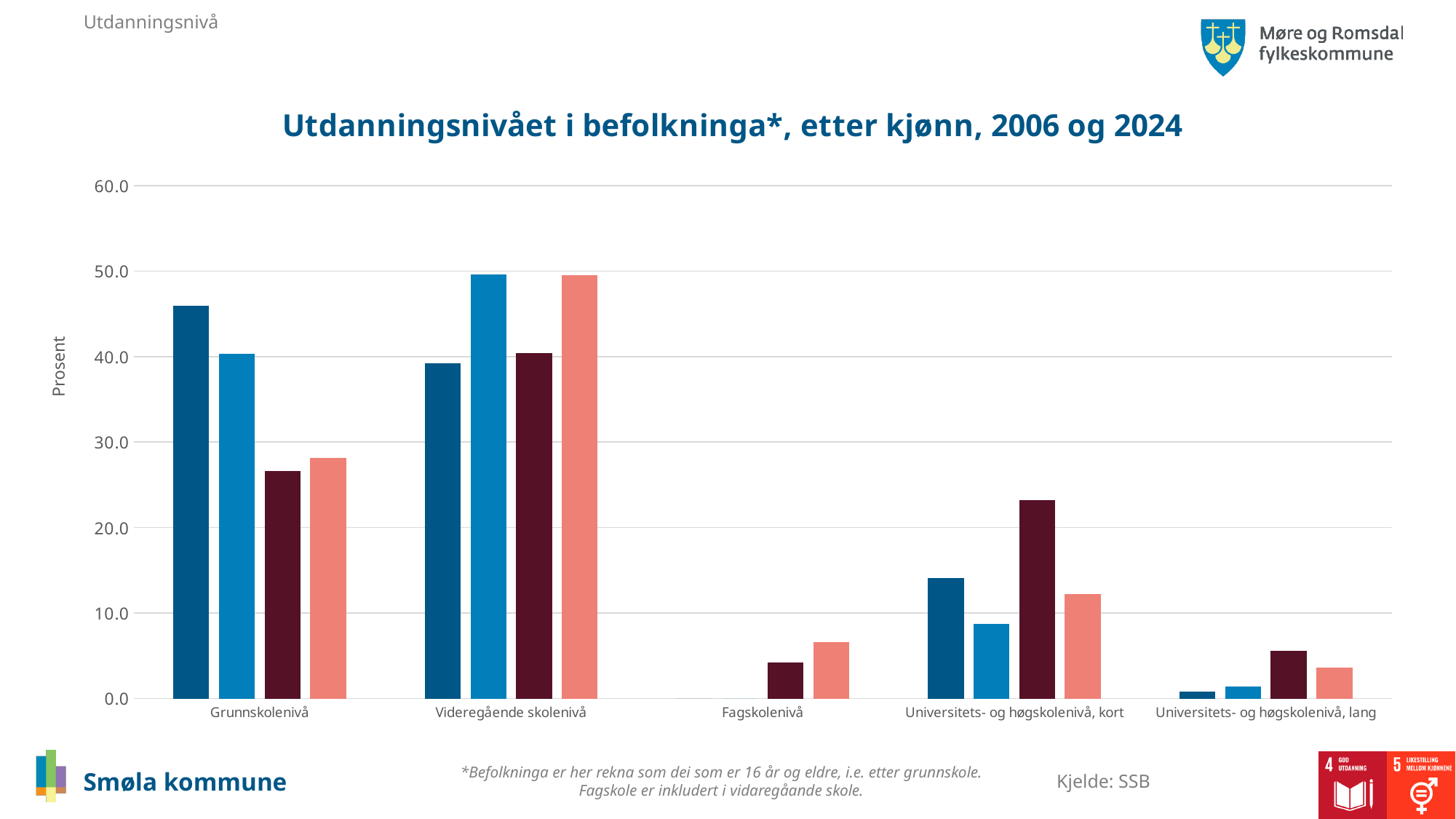
Is the value of the dark blue bar for Grunnskolenivå greater or less than 40? greater Is the value of the dark red bar for Grunnskolenivå greater or less than 30? less What is the label on the vertical axis? Prosent What is the title of the chart? Utdanningsnivået i befolkninga*, etter kjønn, 2006 og 2024 Is the value of the dark blue bar for Universitets- og høgskolenivå, lang greater or less than 10? less How many education-level categories are shown on the x axis? 5 How many bars are plotted for the Grunnskolenivå category? 4 What kind of chart is shown on the slide? bar chart Among the dark blue bars, which category has the highest value? Grunnskolenivå Among the salmon-coloured bars, which category has the lowest value? Universitets- og høgskolenivå, lang For Universitets- og høgskolenivå, kort, which is larger: the dark red bar or the salmon-coloured bar? the dark red bar